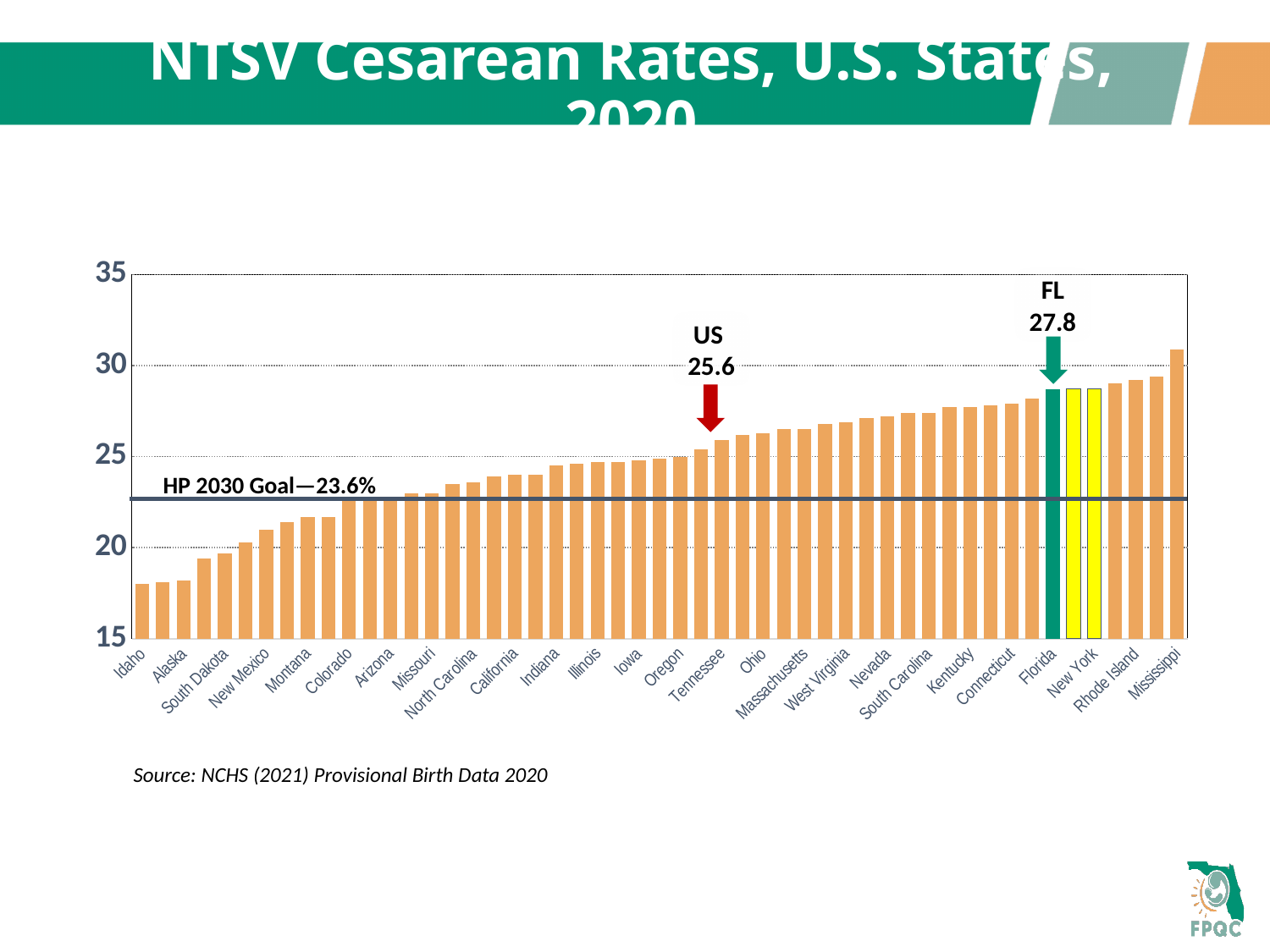
Which is larger, the Florida rate or the US rate? Florida Is the value for Kentucky greater or less than 25? greater What colour is the bar for Florida? green Which state has the highest NTSV cesarean rate on the chart? Mississippi What is the NTSV cesarean rate shown for Florida (FL)? 27.8 What is the difference between the Florida rate and the US rate? 2.2 What is the NTSV cesarean rate shown for the US overall? 25.6 Is the value for Mississippi greater or less than 30? greater Is the value for Idaho greater or less than 20? less What kind of chart is shown on the slide? bar chart What is the HP 2030 Goal value marked by the horizontal line on the chart? 23.6% Do the bar values rise or fall moving from left to right along the x axis? rise